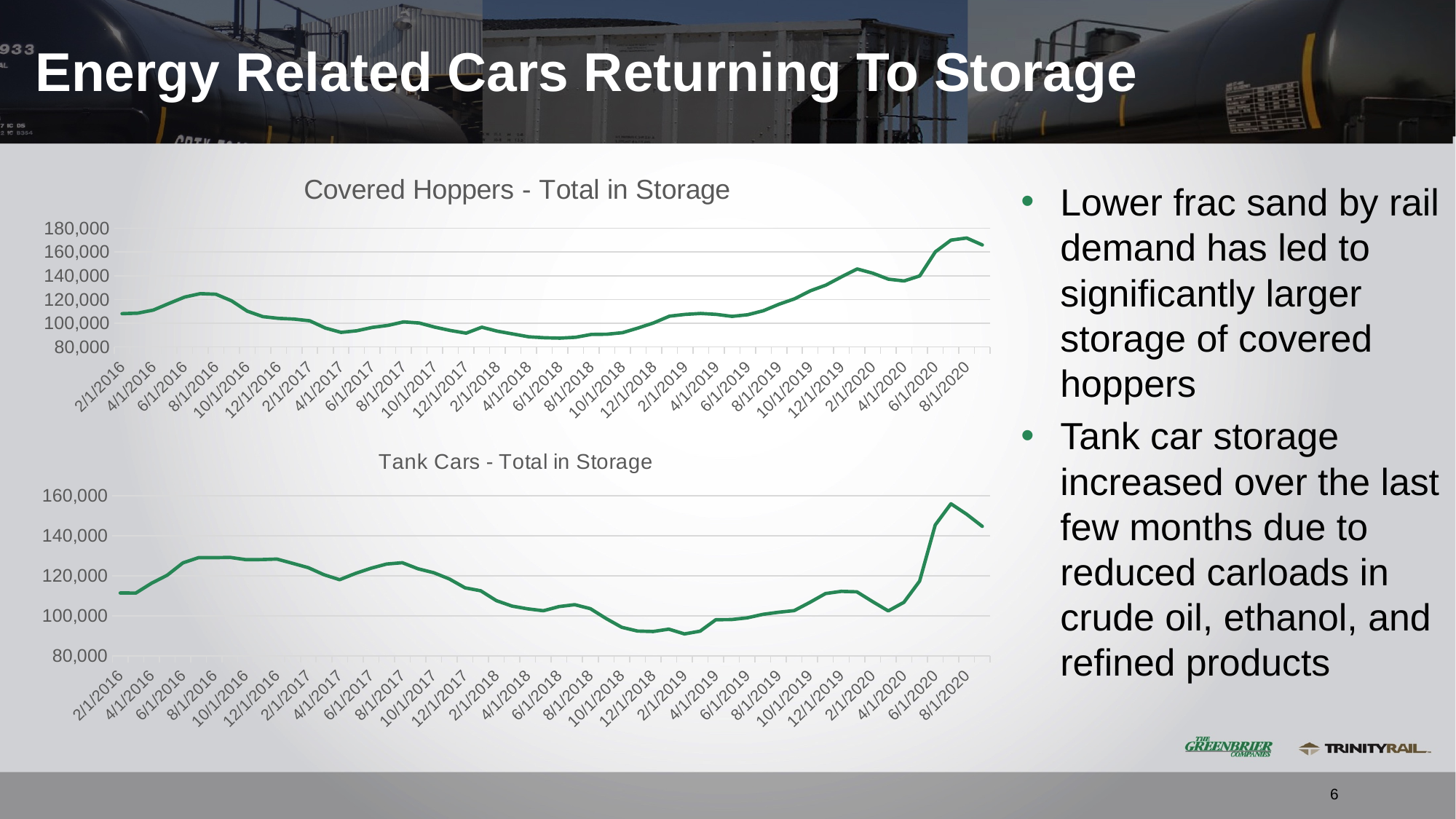
What is the title of the top chart on the slide? Covered Hoppers - Total in Storage In the 'Covered Hoppers - Total in Storage' chart, which is larger, the value for 2/1/2016 or the value for 8/1/2020? 8/1/2020 In the 'Tank Cars - Total in Storage' chart, is the value for 12/1/2018 greater or less than 100,000? less In the 'Covered Hoppers - Total in Storage' chart, is the value for 6/1/2018 greater or less than 100,000? less In the 'Covered Hoppers - Total in Storage' chart, is the value for 8/1/2020 greater or less than 160,000? greater In the 'Covered Hoppers - Total in Storage' chart, does the value rise or fall overall from 2/1/2016 to 8/1/2020? rise In the 'Tank Cars - Total in Storage' chart, which is larger, the value for 2/1/2019 or the value for 8/1/2020? 8/1/2020 What kind of chart is the 'Covered Hoppers - Total in Storage' chart? line chart What kind of chart is the 'Tank Cars - Total in Storage' chart? line chart